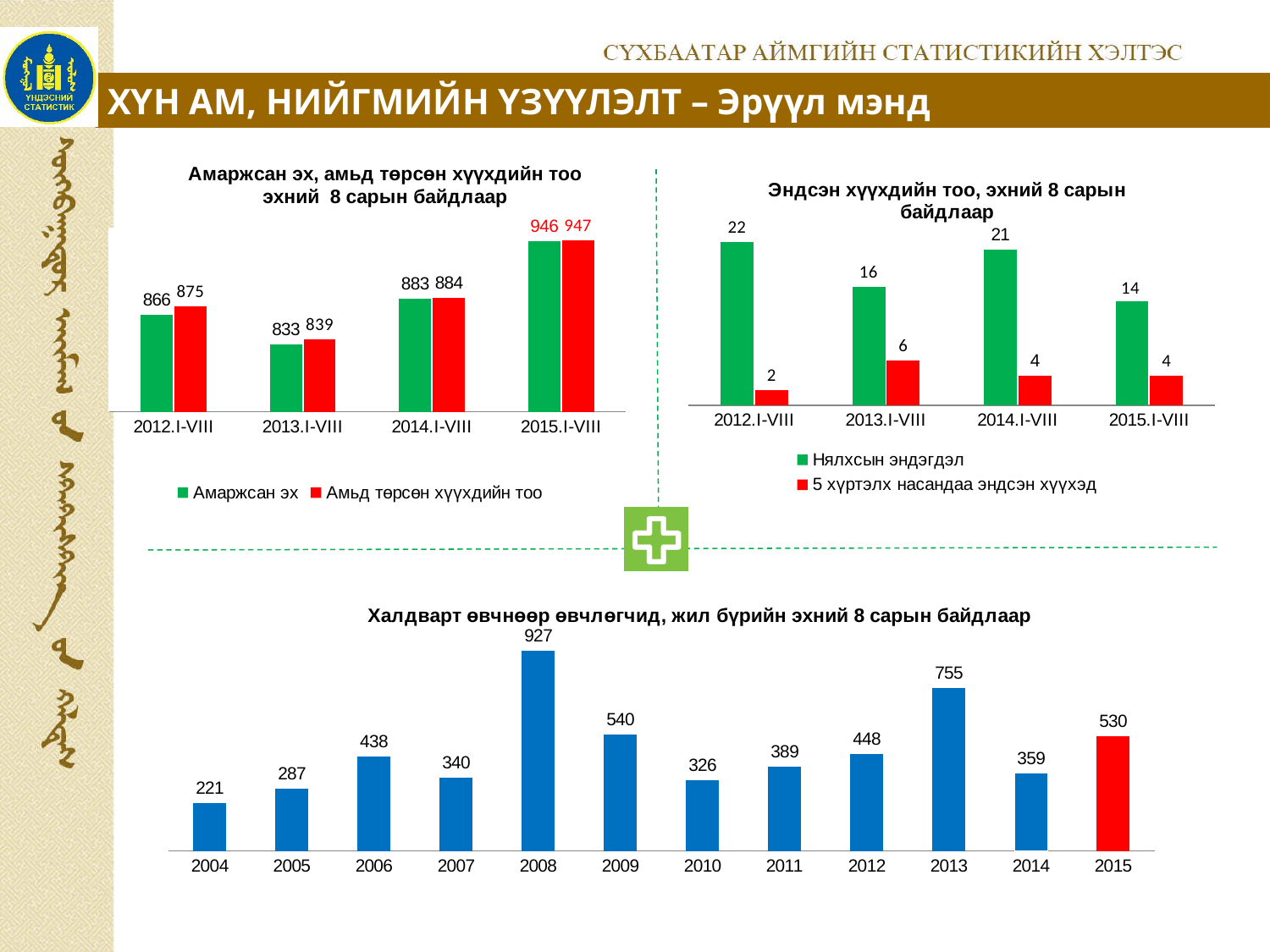
In the top-left chart (Амаржсан эх, амьд төрсөн хүүхдийн тоо), what is the value for Амьд төрсөн хүүхдийн тоо in 2013.I-VIII? 839 In the bottom chart (Халдварт өвчнөөр өвчлөгчид), how many years are shown on the x axis? 12 What kind of chart is the bottom chart (Халдварт өвчнөөр өвчлөгчид)? Bar chart In the bottom chart (Халдварт өвчнөөр өвчлөгчид), which year has the highest value? 2008 In the bottom chart (Халдварт өвчнөөр өвчлөгчид), what is the value for 2013? 755 In the top-right chart (Эндсэн хүүхдийн тоо), which period has the lowest value for Нялхсын эндэгдэл? 2015.I-VIII In the top-right chart (Эндсэн хүүхдийн тоо), what is the difference between Нялхсын эндэгдэл and 5 хүртэлх насандаа эндсэн хүүхэд in 2012.I-VIII? 20 In the top-left chart (Амаржсан эх, амьд төрсөн хүүхдийн тоо), what is the value for Амаржсан эх in 2015.I-VIII? 946 In the top-left chart (Амаржсан эх, амьд төрсөн хүүхдийн тоо), what is the difference between Амьд төрсөн хүүхдийн тоо and Амаржсан эх in 2012.I-VIII? 9 In the top-right chart (Эндсэн хүүхдийн тоо), what is the value for Нялхсын эндэгдэл in 2014.I-VIII? 21 In the top-right chart (Эндсэн хүүхдийн тоо), which period has the highest value for 5 хүртэлх насандаа эндсэн хүүхэд? 2013.I-VIII In the top-left chart (Амаржсан эх, амьд төрсөн хүүхдийн тоо), how many series does the legend list? 2